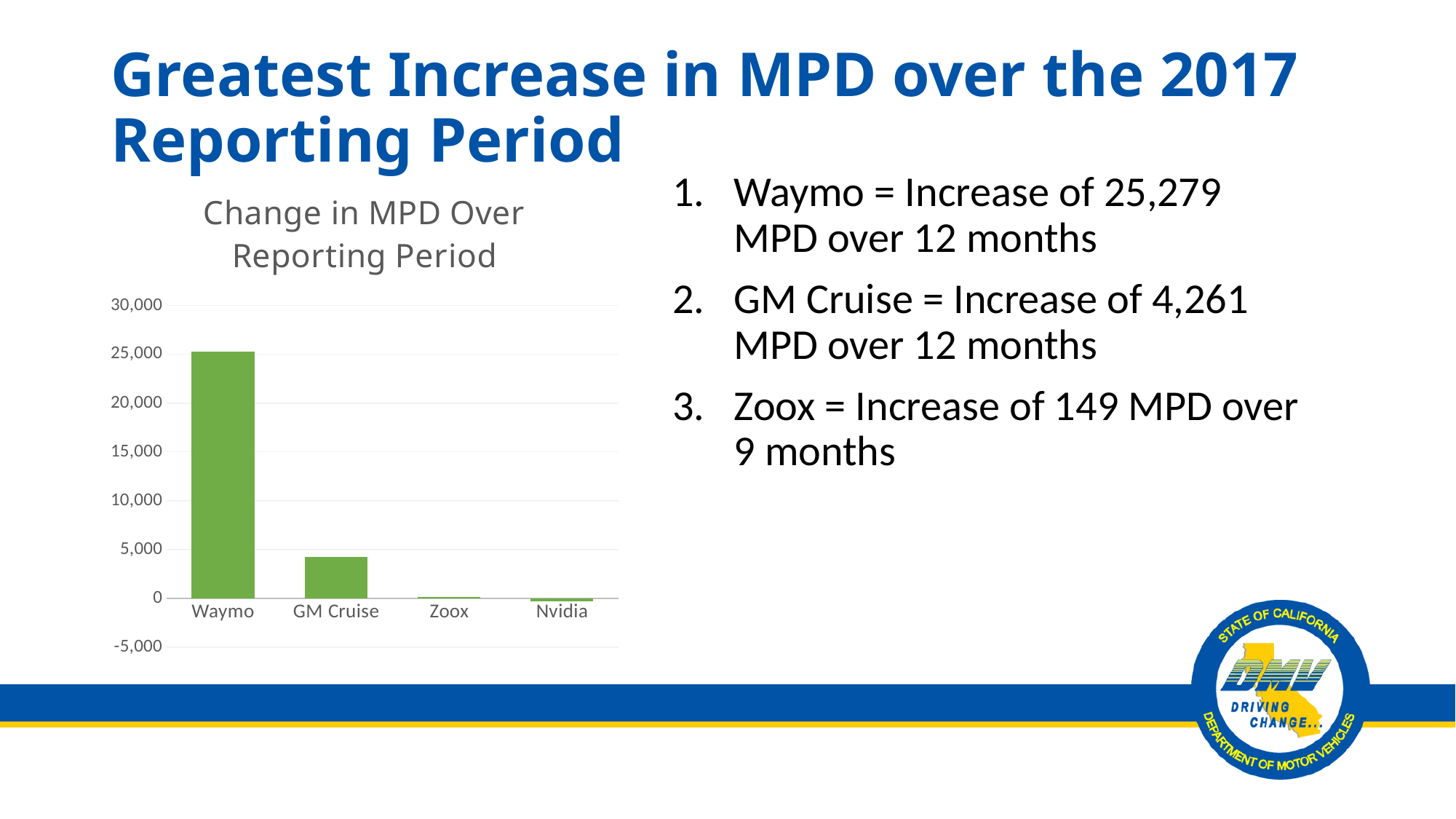
According to the slide, what is the increase in MPD for GM Cruise over the reporting period? 4,261 Which is larger, the change in MPD for GM Cruise or for Zoox? GM Cruise According to the slide, what is the increase in MPD for Waymo over the reporting period? 25,279 How many companies are shown on the x axis of the chart? 4 Which company has the highest change in MPD over the reporting period? Waymo Is the value for Waymo greater or less than 20,000? greater What colour are the bars in the chart? green Is the value for Nvidia greater or less than 5,000? less What kind of chart is shown on the slide? bar chart Is the value for GM Cruise greater or less than 5,000? less What is the title of the chart? Change in MPD Over Reporting Period Which is larger, the change in MPD for Waymo or for GM Cruise? Waymo